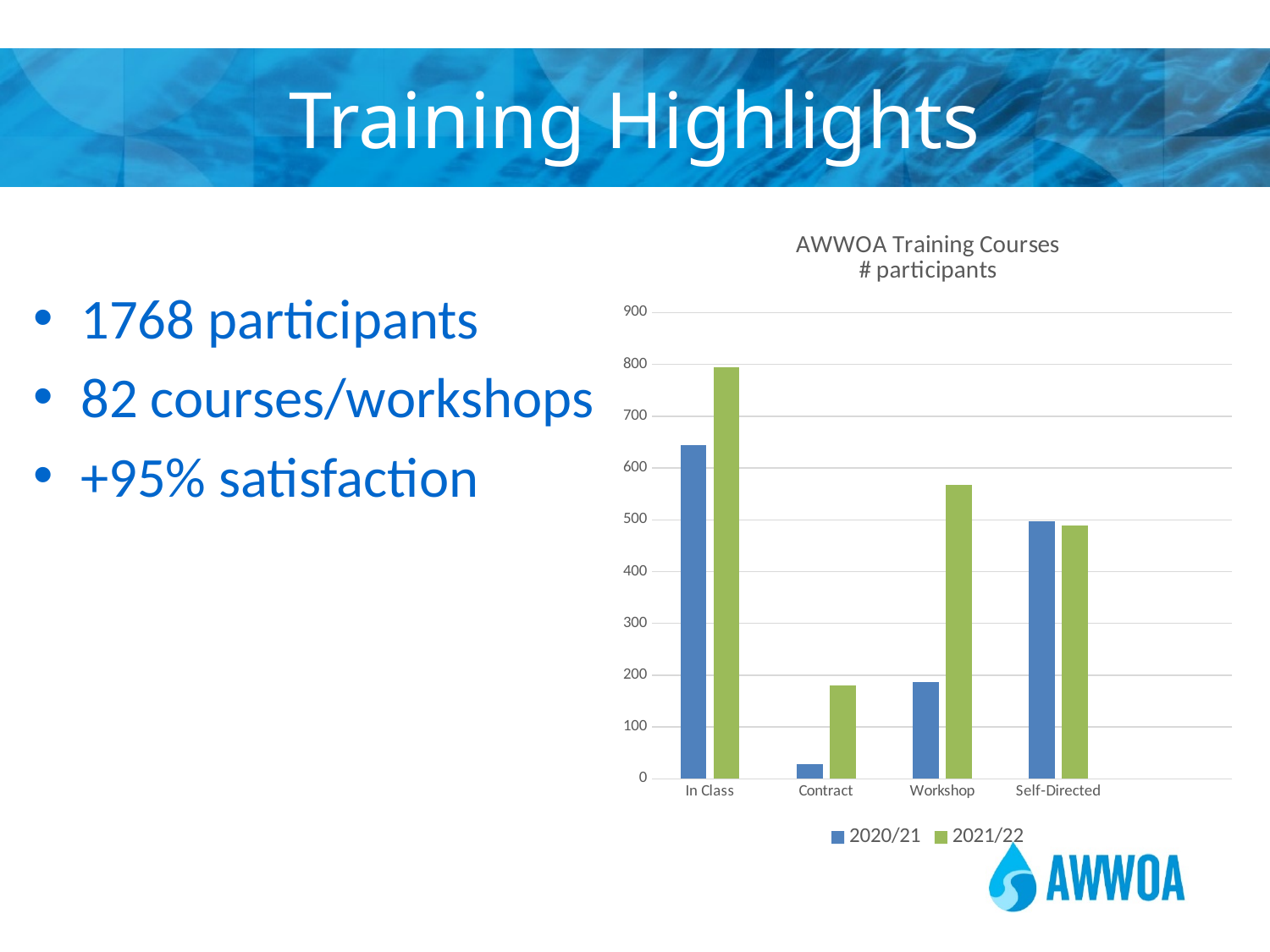
Which category has the lowest value for the 2020/21 series? Contract Which series is shown in green in the chart? 2021/22 What kind of chart is shown on the slide? Bar chart For In Class, which series has the larger value, 2020/21 or 2021/22? 2021/22 What is the title of the chart? AWWOA Training Courses # participants Is the 2020/21 value for Contract greater or less than 100? less Is the 2021/22 value for In Class greater or less than 700? greater How many series does the chart's legend list? 2 Which category has the highest value for the 2021/22 series? In Class For Workshop, which series has the larger value, 2020/21 or 2021/22? 2021/22 How many categories are shown on the x axis of the chart? 4 Is the 2021/22 value for Workshop greater or less than 500? greater